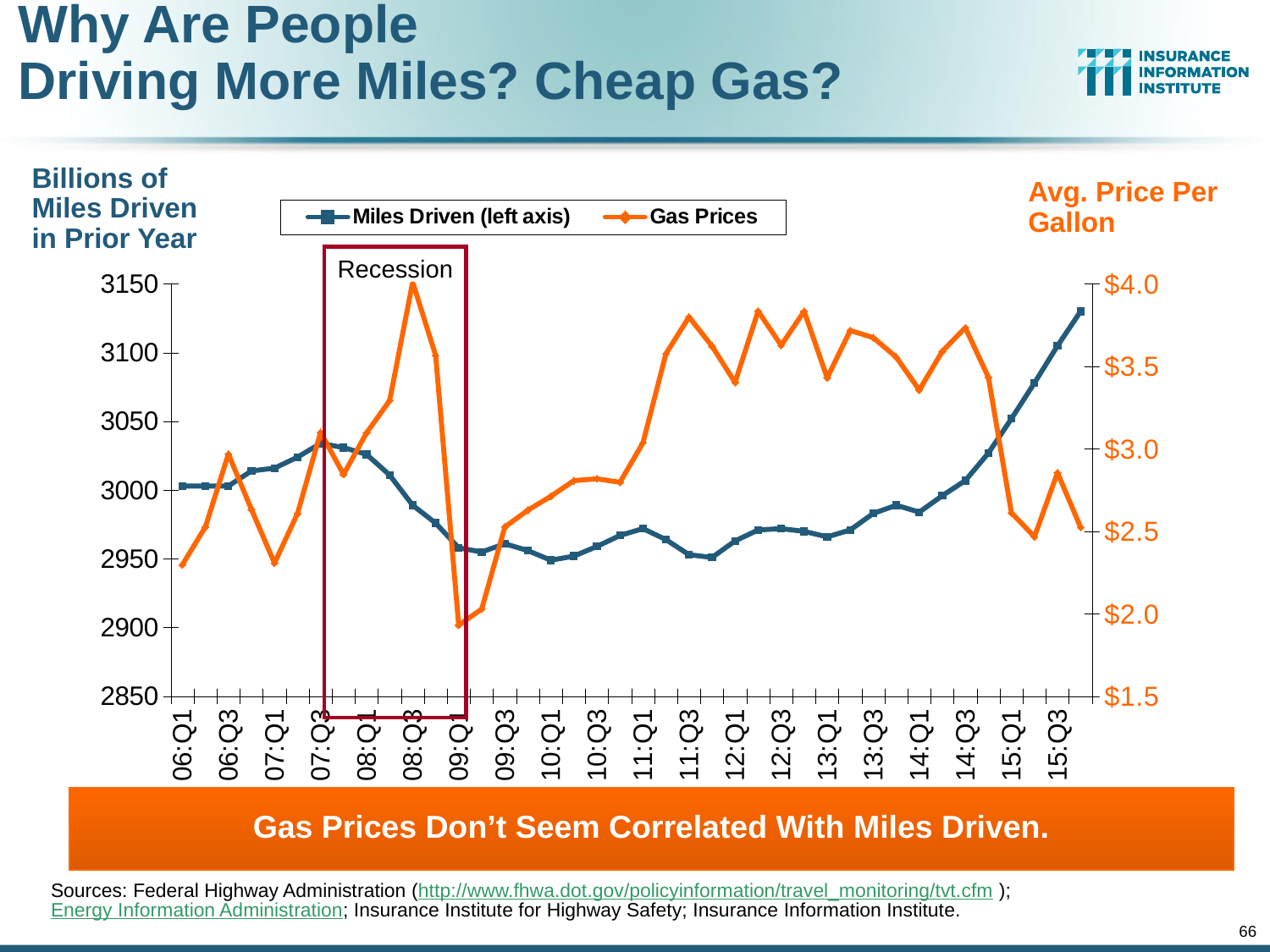
Is the Miles Driven value for 07:Q3 greater or less than 3000? greater Is the Gas Prices value for 06:Q1 greater or less than $2.5? less What kind of chart is shown on the slide? Line chart What label is shown on the boxed region of the chart around 2008? Recession What are the two series named in the legend? Miles Driven (left axis) and Gas Prices In which quarter does the Gas Prices series reach its highest value? 08:Q3 Which is larger, the Miles Driven value for 07:Q3 or for 09:Q1? 07:Q3 Is the Gas Prices value for 08:Q3 greater or less than $3.5? greater How many series does the legend list? 2 Does the Miles Driven series rise or fall from 14:Q1 to 15:Q3? Rise In which quarter does the Gas Prices series reach its lowest value? 09:Q1